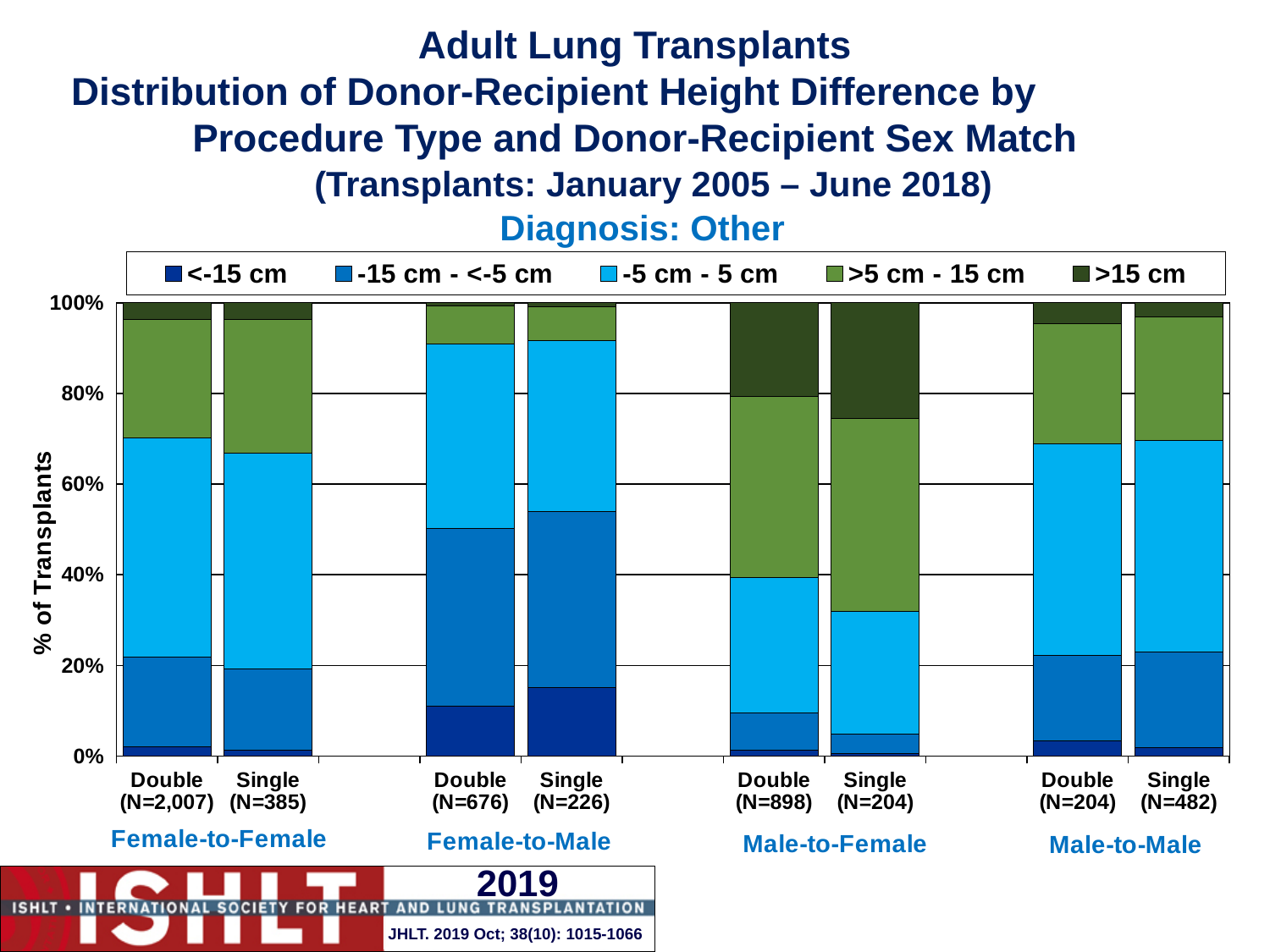
What kind of chart is shown on the slide? Stacked bar chart How many bars are plotted in the chart? 8 Is the value of the -5 cm - 5 cm segment for Female-to-Female Double greater or less than 40%? greater Which is larger: the <-15 cm segment for Female-to-Male Single or for Female-to-Female Single? Female-to-Male Single Is the value of the >15 cm segment for Male-to-Female Single greater or less than 20%? greater What is the total of the stacked bar for Female-to-Female Double? 100% Which is larger: the >15 cm segment for Male-to-Female Double or for Female-to-Female Double? Male-to-Female Double What is the N shown for the Female-to-Female Double bar? N=2,007 Is the value of the >5 cm - 15 cm segment for Male-to-Female Single greater or less than 30%? greater How many series does the legend list? 5 Which bar has the largest <-15 cm segment? Female-to-Male Single